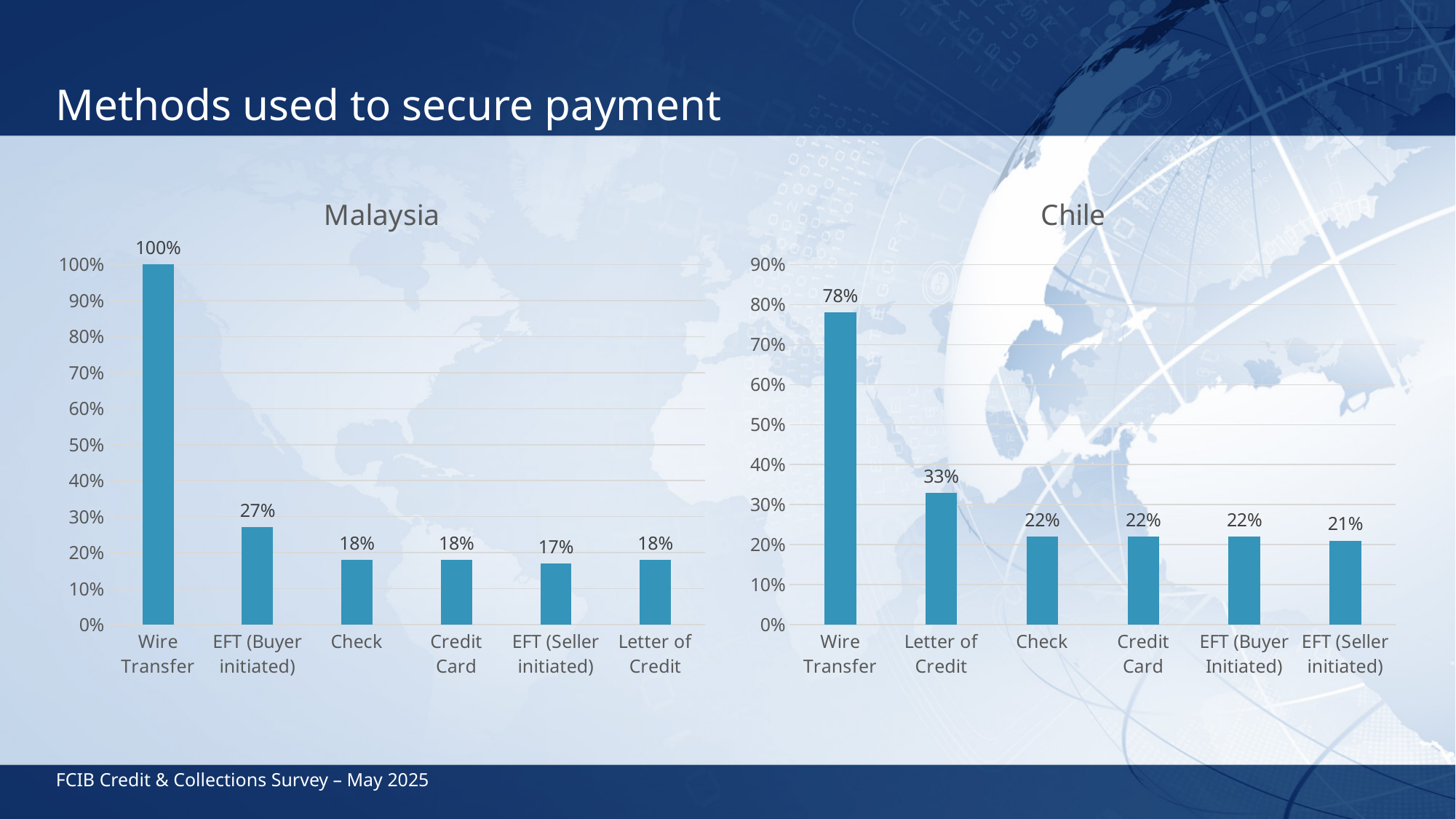
In the Chile chart, is the value for Letter of Credit greater or less than 30%? greater In the Malaysia chart, what is the value for Wire Transfer? 100% In the Chile chart, what is the difference between Wire Transfer and Letter of Credit? 45% In the Chile chart, what is the value for Letter of Credit? 33% In the Malaysia chart, which category has the lowest value? EFT (Seller initiated) In the Chile chart, what is the value for EFT (Seller initiated)? 21% In the Chile chart, which category has the highest value? Wire Transfer How many categories are shown in the Malaysia chart? 6 In the Malaysia chart, what is the difference between Wire Transfer and EFT (Buyer initiated)? 73% In the Malaysia chart, what is the value for EFT (Buyer initiated)? 27% Which is larger: Wire Transfer in the Malaysia chart or Wire Transfer in the Chile chart? Malaysia What type of chart is the Chile chart? Bar chart